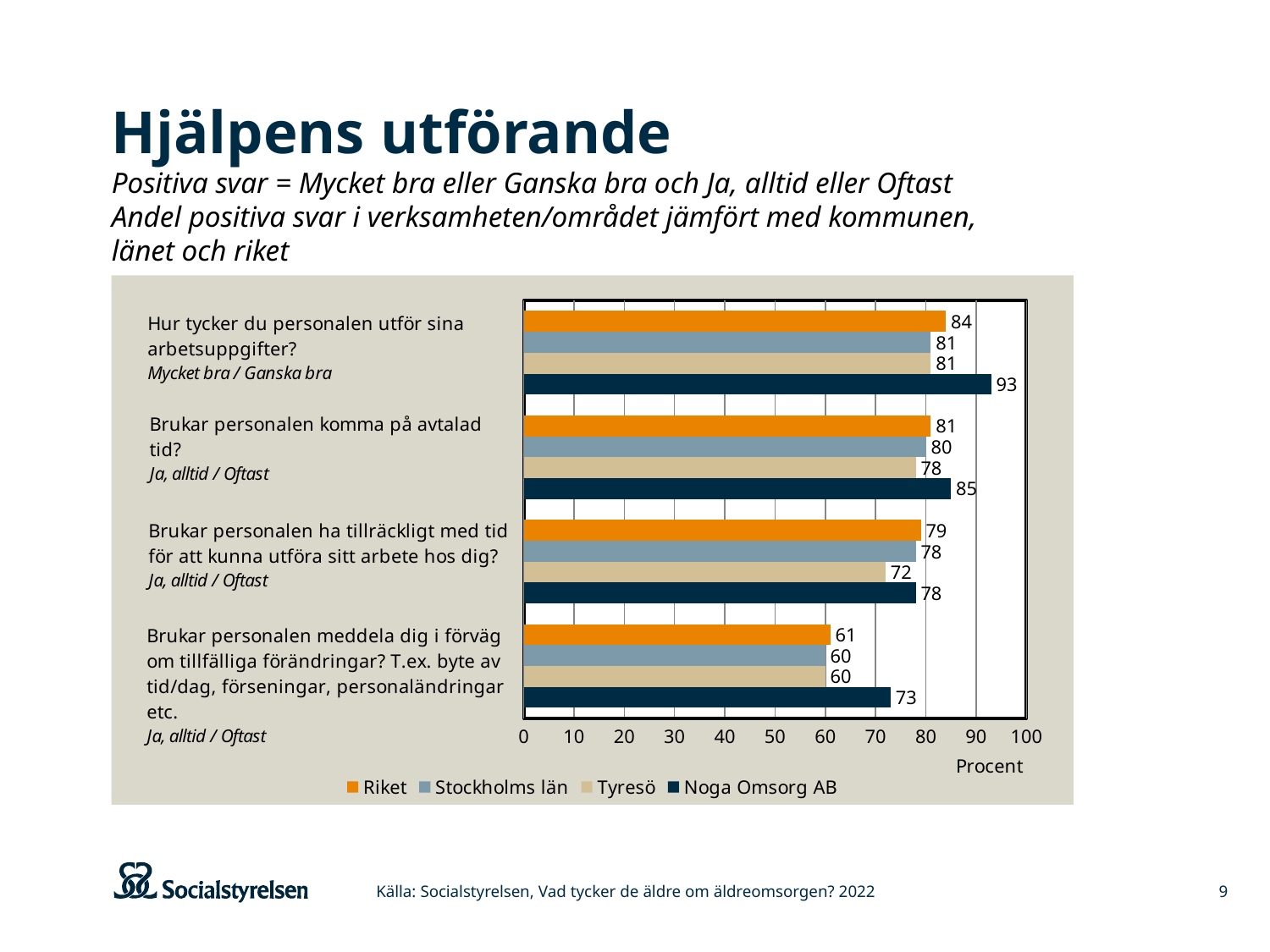
How many series does the legend list? 4 What is the value for Tyresö for the question "Brukar personalen ha tillräckligt med tid för att kunna utföra sitt arbete hos dig?"? 72 What is the value for Noga Omsorg AB for the question "Hur tycker du personalen utför sina arbetsuppgifter?"? 93 How many question categories are shown on the chart? 4 Which series has the lowest value for the question "Brukar personalen ha tillräckligt med tid för att kunna utföra sitt arbete hos dig?"? Tyresö Which series has the highest value for the question "Brukar personalen meddela dig i förväg om tillfälliga förändringar?"? Noga Omsorg AB What type of chart is shown on the slide? bar chart What is the value for Riket for the question "Brukar personalen komma på avtalad tid?"? 81 What is the difference between Noga Omsorg AB and Riket for the question "Hur tycker du personalen utför sina arbetsuppgifter?"? 9 What is the value for Stockholms län for the question "Brukar personalen meddela dig i förväg om tillfälliga förändringar?"? 60 Which is larger for the question "Brukar personalen komma på avtalad tid?": Noga Omsorg AB or Tyresö? Noga Omsorg AB What label is shown on the horizontal axis of the chart? Procent